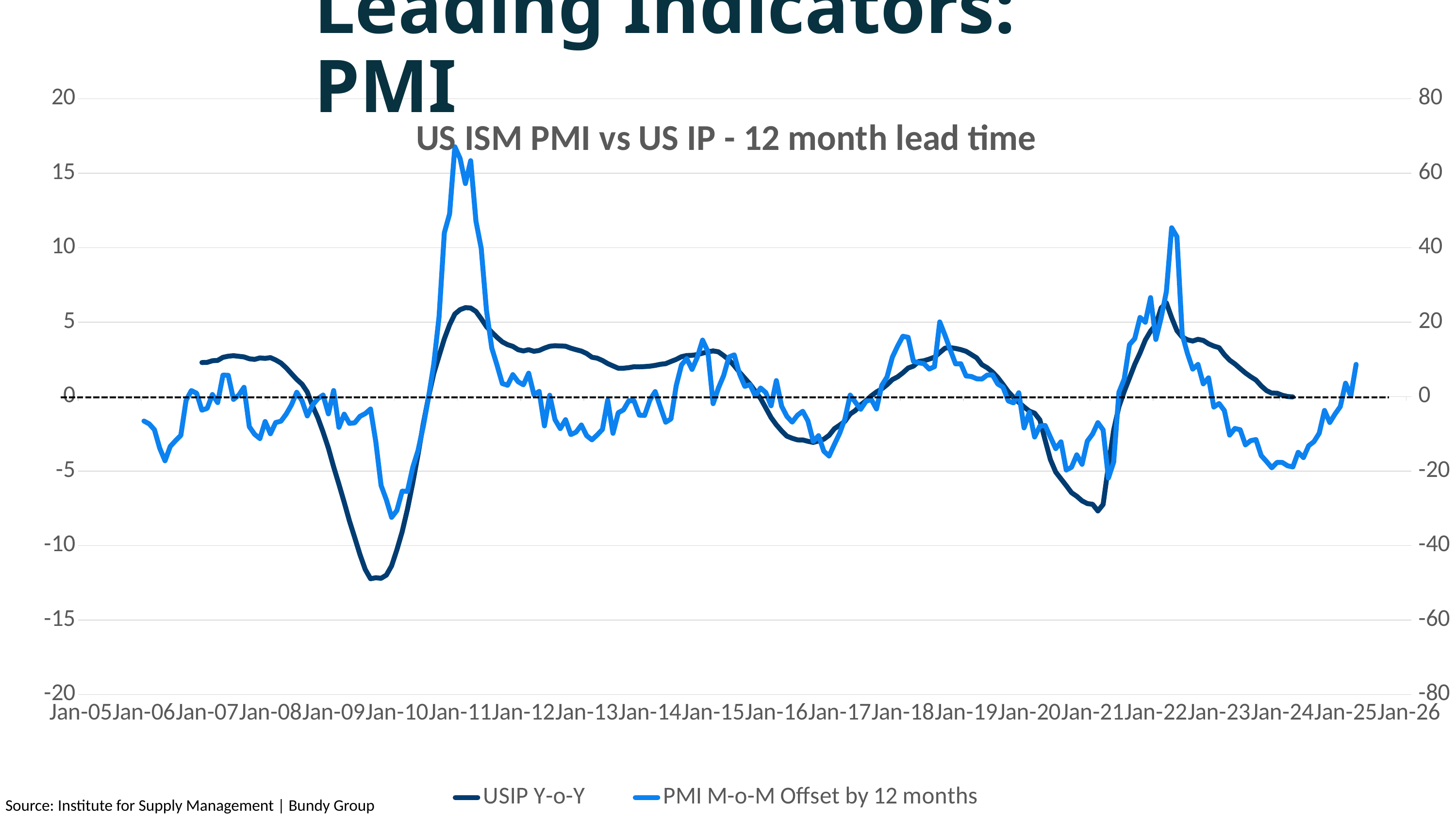
What kind of chart is shown on the slide? line chart Is the peak of the PMI M-o-M Offset by 12 months line around Jan-11 greater or less than 60 on the right axis? greater Does the PMI M-o-M Offset by 12 months line rise or fall between Jan-24 and Jan-25? rise Is the lowest value of the USIP Y-o-Y line, reached around Jan-10, greater or less than -10 on the left axis? less Does the USIP Y-o-Y line rise or fall between Jan-22 and Jan-24? fall Is the trough of the USIP Y-o-Y line around Jan-21 greater or less than -5 on the left axis? less How many year labels are shown on the x axis? 22 How many series does the legend list? 2 Which series is drawn in the lighter blue line? PMI M-o-M Offset by 12 months What is the title of the chart? US ISM PMI vs US IP - 12 month lead time